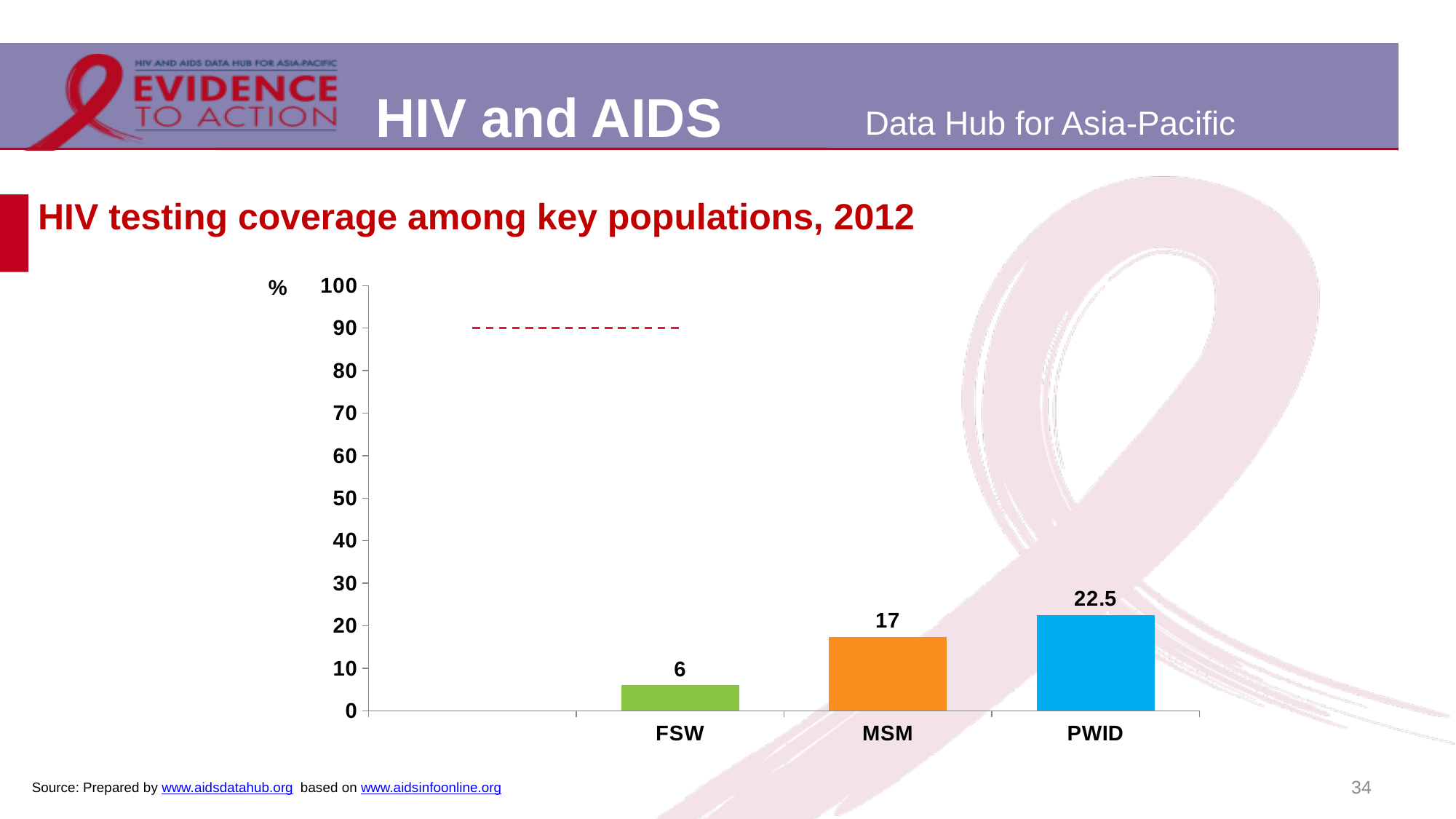
How many key populations are shown on the chart? 3 Is the value for PWID greater or less than 20? greater Which key population has the highest HIV testing coverage? PWID Which has a higher HIV testing coverage, FSW or MSM? MSM What is the difference between the HIV testing coverage for MSM and FSW? 11 Which key population has the lowest HIV testing coverage? FSW What is the HIV testing coverage value for PWID? 22.5 What is the HIV testing coverage value for MSM? 17 What is the difference between the HIV testing coverage for PWID and MSM? 5.5 What is the title of the chart? HIV testing coverage among key populations, 2012 What is the HIV testing coverage value for FSW? 6 What kind of chart is shown on the slide? Bar chart